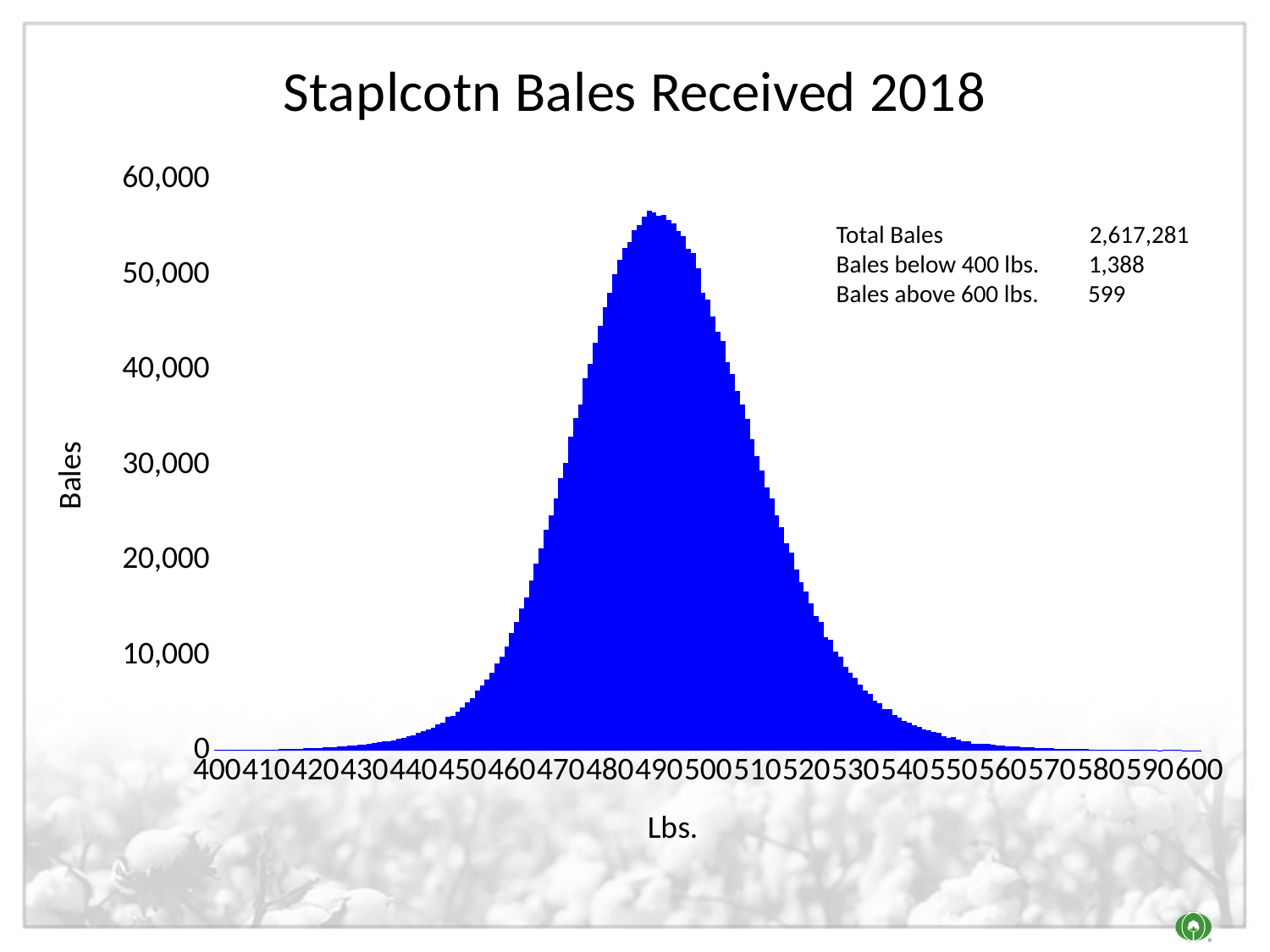
What kind of chart is shown on the slide? bar chart Is the value for 470 lbs. greater or less than 20,000? greater Which is larger, the value for 490 lbs. or the value for 550 lbs.? 490 lbs. Is the value for 440 lbs. greater or less than 10,000? less What is the total number of bales stated on the slide? 2,617,281 Is the value for 490 lbs. greater or less than 50,000? greater How do the values change along the x axis from 400 to 600 lbs.? They rise to a peak near 490 and then fall What is the title of the chart? Staplcotn Bales Received 2018 What is the label of the x axis? Lbs.